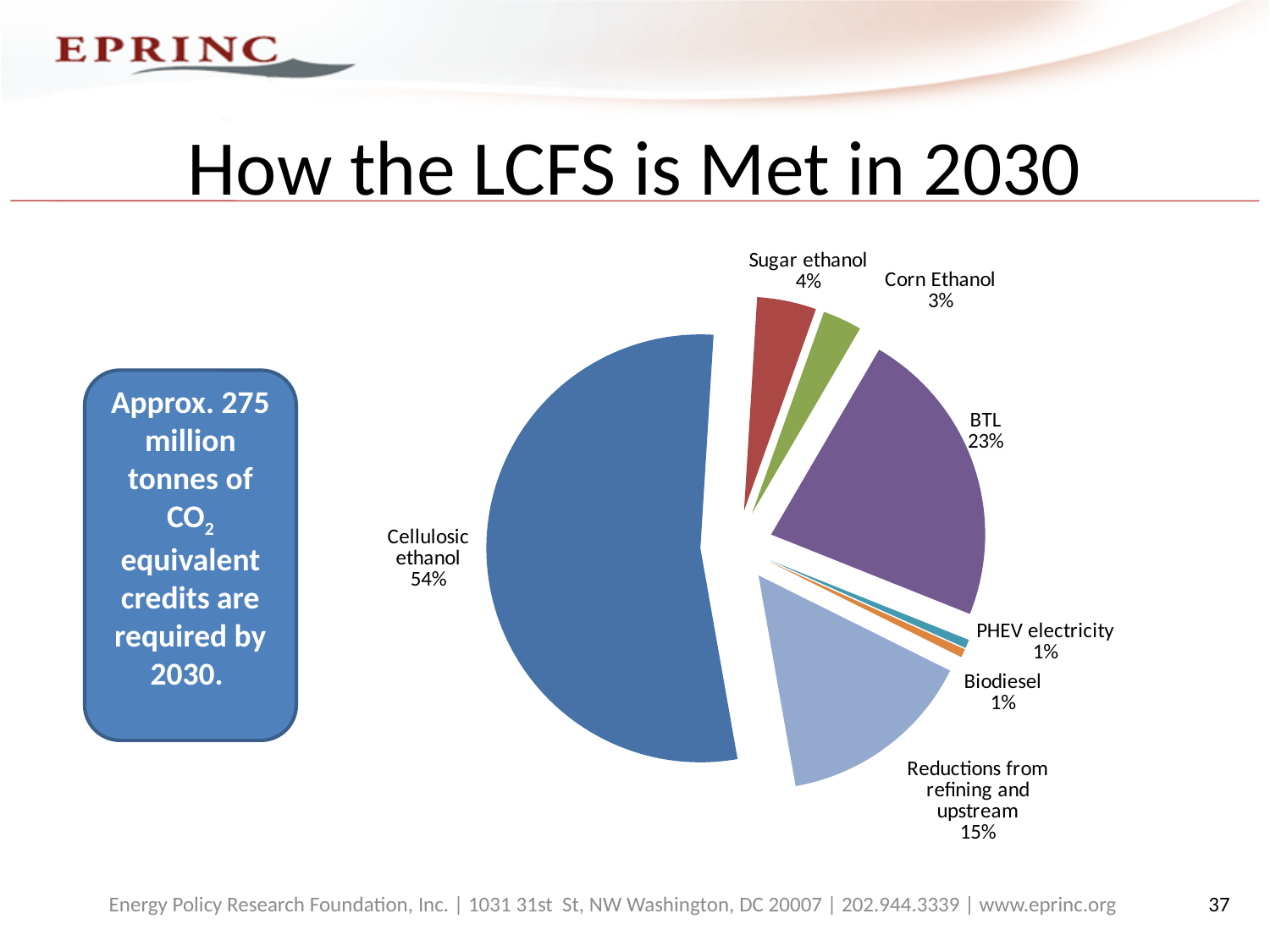
Which category has the largest slice of the pie? Cellulosic ethanol What is the title of the slide containing the pie chart? How the LCFS is Met in 2030 How many slices does the pie chart have? 7 What percentage is shown for PHEV electricity? 1% What is the value shown for Corn Ethanol? 3% What is the value shown for BTL? 23% Which is larger, the share for Sugar ethanol or the share for Corn Ethanol? Sugar ethanol What percentage is shown for Reductions from refining and upstream? 15% What kind of chart is shown on the slide? Pie chart What share of the pie does Cellulosic ethanol account for? 54% What is the value shown for Sugar ethanol? 4% What is the difference between the shares for Cellulosic ethanol and BTL? 31%